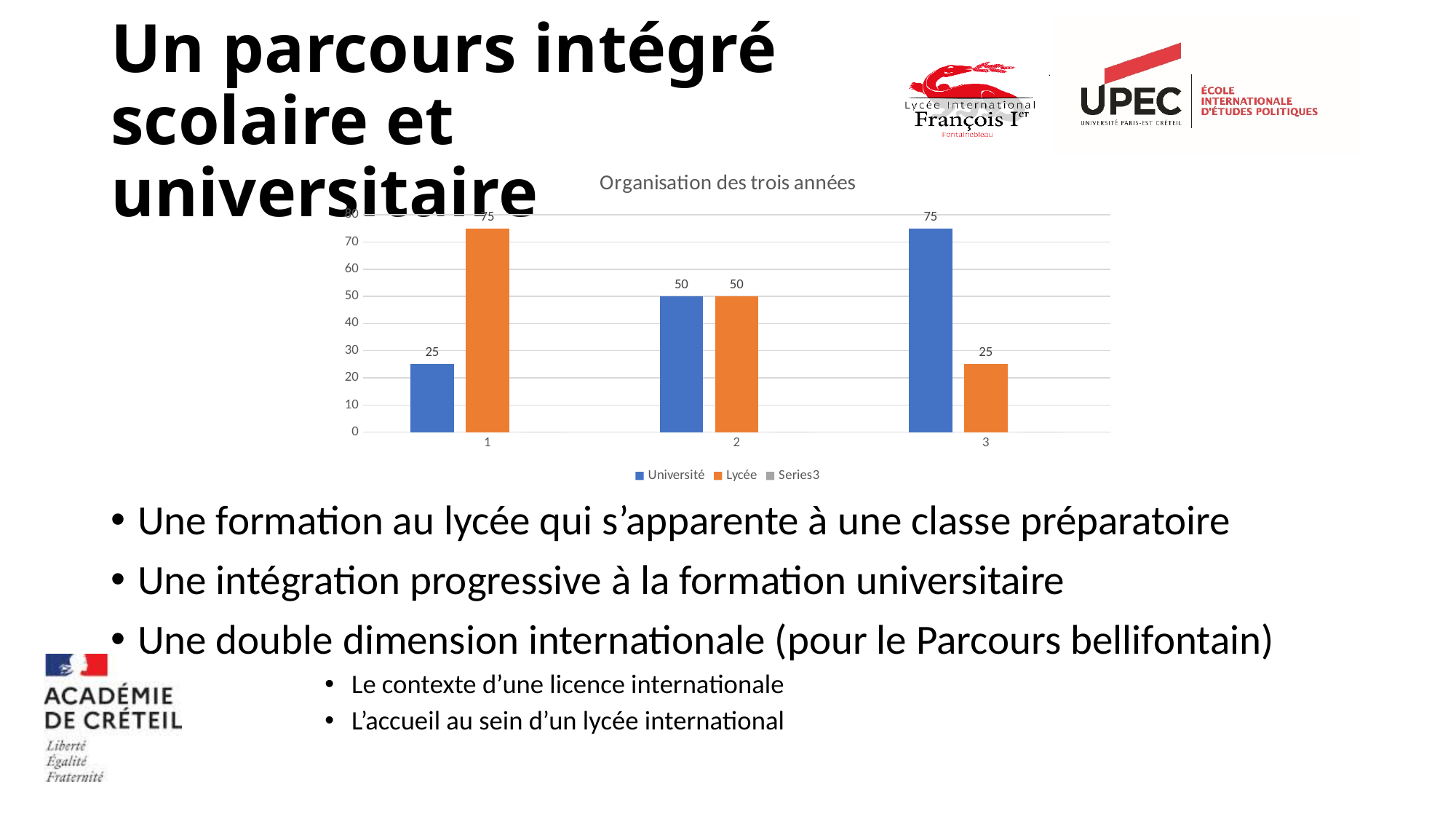
How many categories are shown on the x axis? 3 What is the value for Lycée in category 3? 25 What is the value for Université in category 3? 75 What is the difference between the Lycée and Université values in category 1? 50 What kind of chart is shown? bar chart In which category is the Lycée value lowest? 3 In which category is the Université value highest? 3 What is the value for Lycée in category 1? 75 How many series does the legend list? 3 Which is larger in category 3, Université or Lycée? Université What is the value for Université in category 1? 25 What is the title of the chart? Organisation des trois années